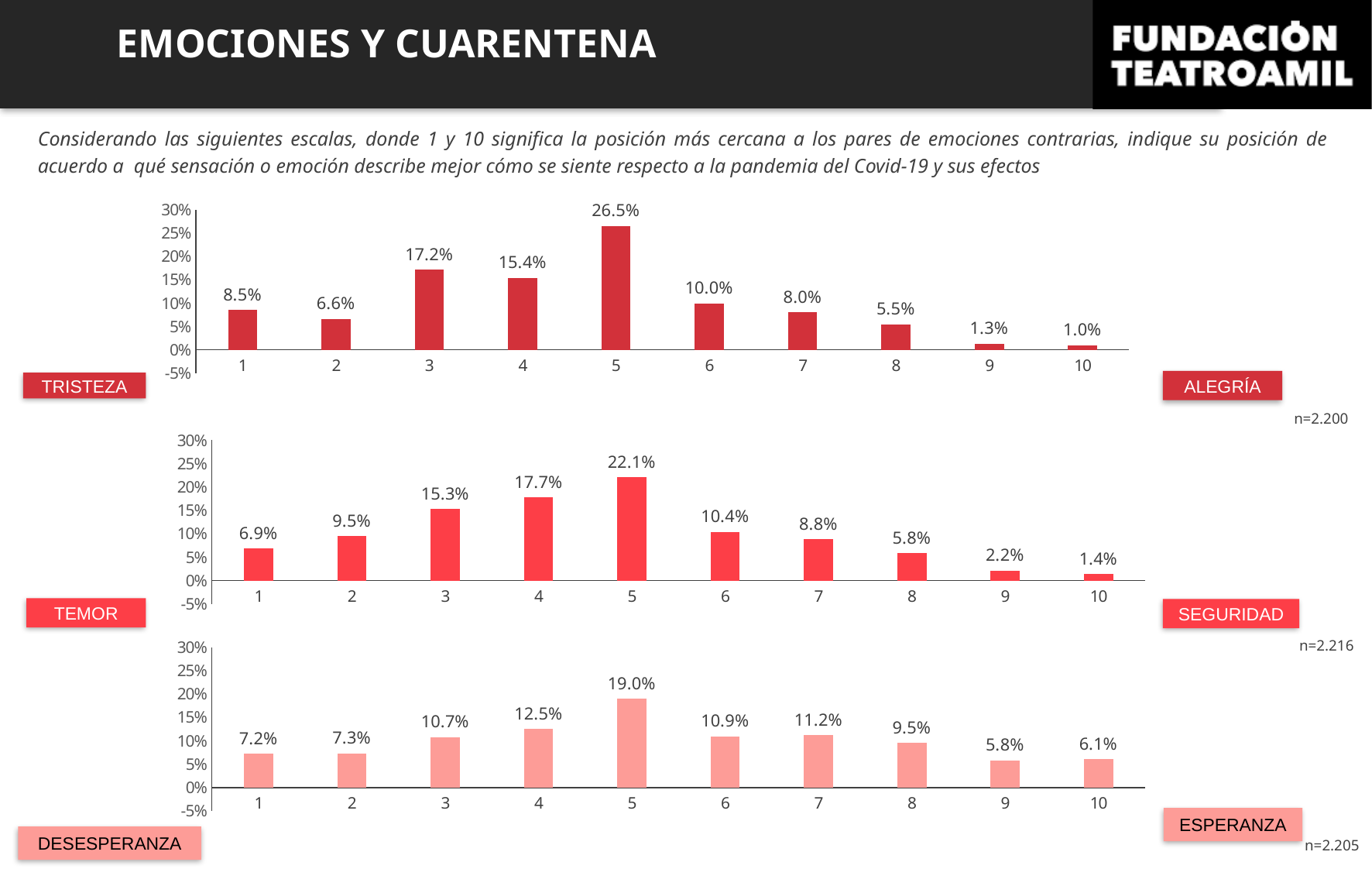
In the middle chart (Temor–Seguridad), what is the value for scale point 3? 15.3% What type of chart is the top chart (Tristeza–Alegría)? Bar chart In the top chart (Tristeza–Alegría), do the values rise or fall from scale point 5 to scale point 10? Fall In the top chart (Tristeza–Alegría), which scale point has the lowest value? 10 In the bottom chart (Desesperanza–Esperanza), what is the value for scale point 10? 6.1% In the middle chart (Temor–Seguridad), is the value for scale point 4 greater or less than 15%? greater In the top chart (Tristeza–Alegría), which is larger, the value for scale point 3 or scale point 4? 3 How many scale points are shown on the x axis of the bottom chart (Desesperanza–Esperanza)? 10 In the top chart (Tristeza–Alegría), what is the value for scale point 5? 26.5% In the bottom chart (Desesperanza–Esperanza), what is the difference between the values for scale points 5 and 4? 6.5% In the middle chart (Temor–Seguridad), which scale point has the highest value? 5 What is the sample size (n) shown for the middle chart (Temor–Seguridad)? n=2.216